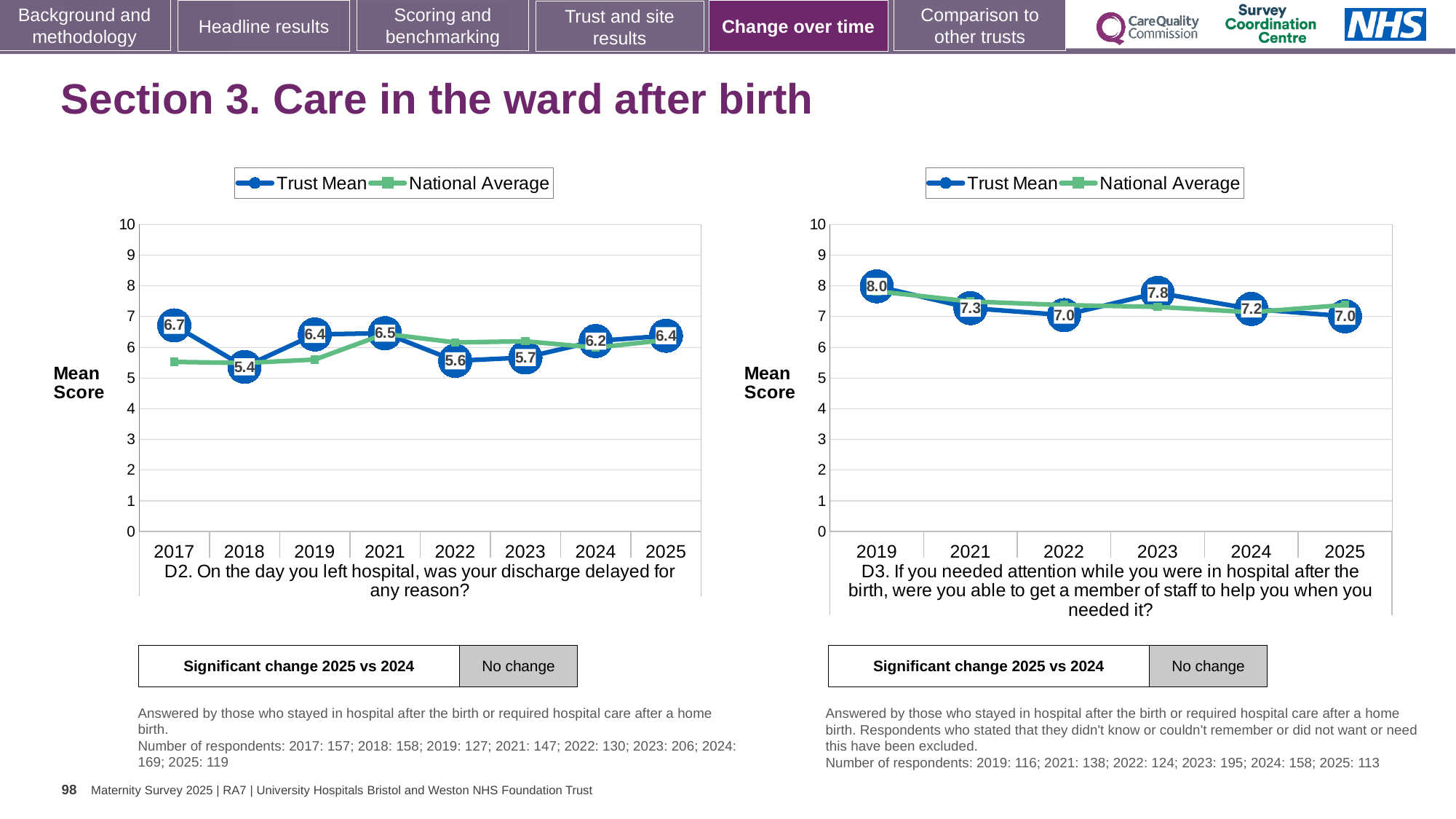
In the D3 chart (right), what is the difference between the Trust Mean scores for 2019 and 2025? 1.0 In the D2 chart (left), which year has the lowest Trust Mean score? 2018 In the D3 chart (right), is the National Average for 2019 greater or less than 7? greater In the D2 chart (left), which year has the highest Trust Mean score? 2017 How many years are plotted on the x axis of the D3 chart (right)? 6 In the D2 chart (left), is the Trust Mean score higher in 2019 or in 2022? 2019 What type of chart is used for the D2 chart (left)? Line chart In the D2 chart (left), what is the Trust Mean score for 2018? 5.4 In the D2 chart (left), what is the Trust Mean score for 2025? 6.4 How many series does the legend of the D2 chart (left) list? 2 In the D3 chart (right), what is the Trust Mean score for 2023? 7.8 In the D3 chart (right), which year has the highest Trust Mean score? 2019